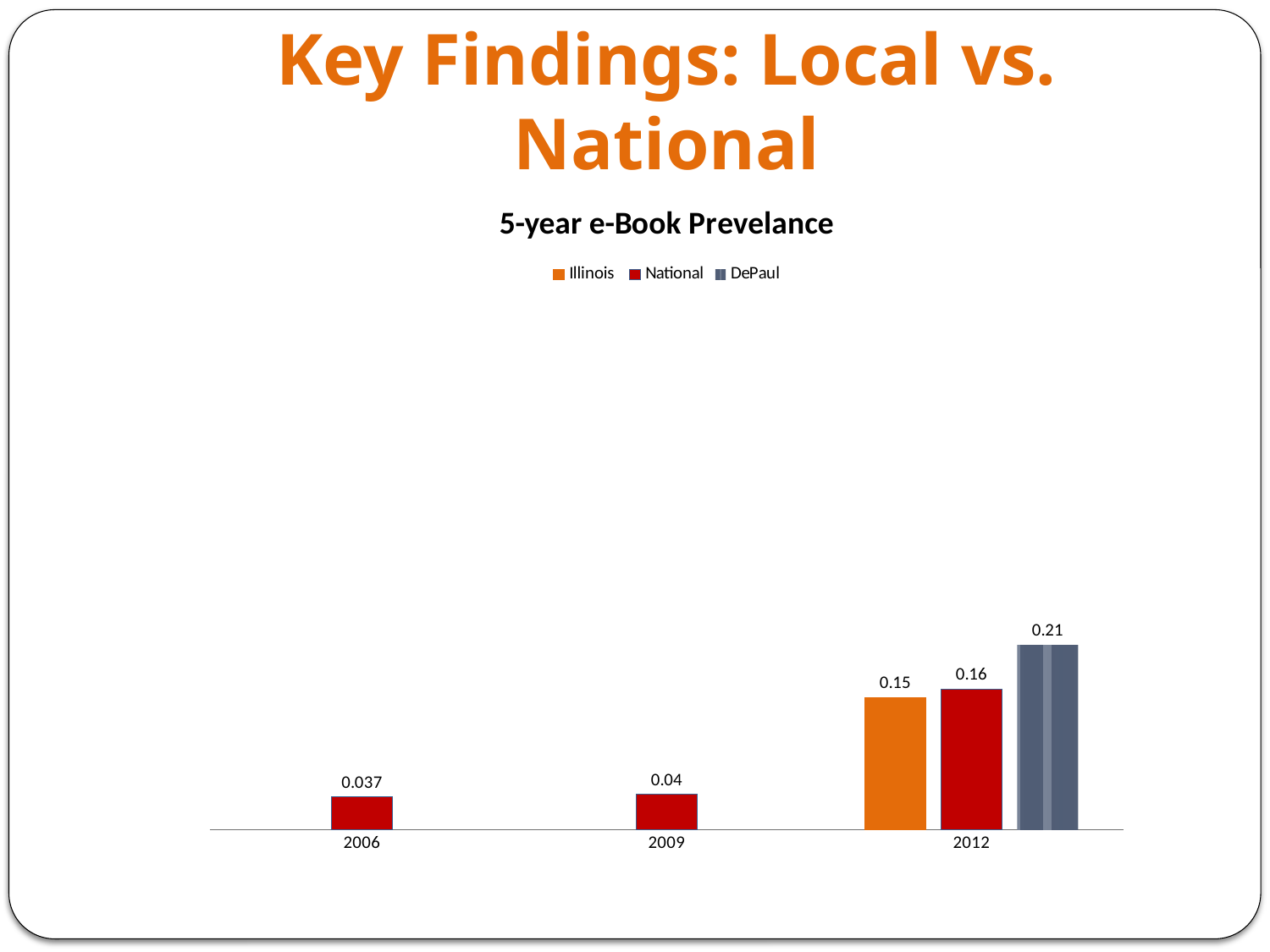
How many series does the legend list? 3 What is the National value for 2009? 0.04 Which series has the highest value in 2012? DePaul What kind of chart is shown on the slide? Bar chart What is the DePaul value for 2012? 0.21 What is the difference between the DePaul and Illinois values in 2012? 0.06 What is the Illinois value for 2012? 0.15 What is the National value for 2012? 0.16 In which year is the National value lowest? 2006 Which is larger in 2012, the National value or the Illinois value? National What is the National value for 2006? 0.037 How many years are shown on the x axis? 3